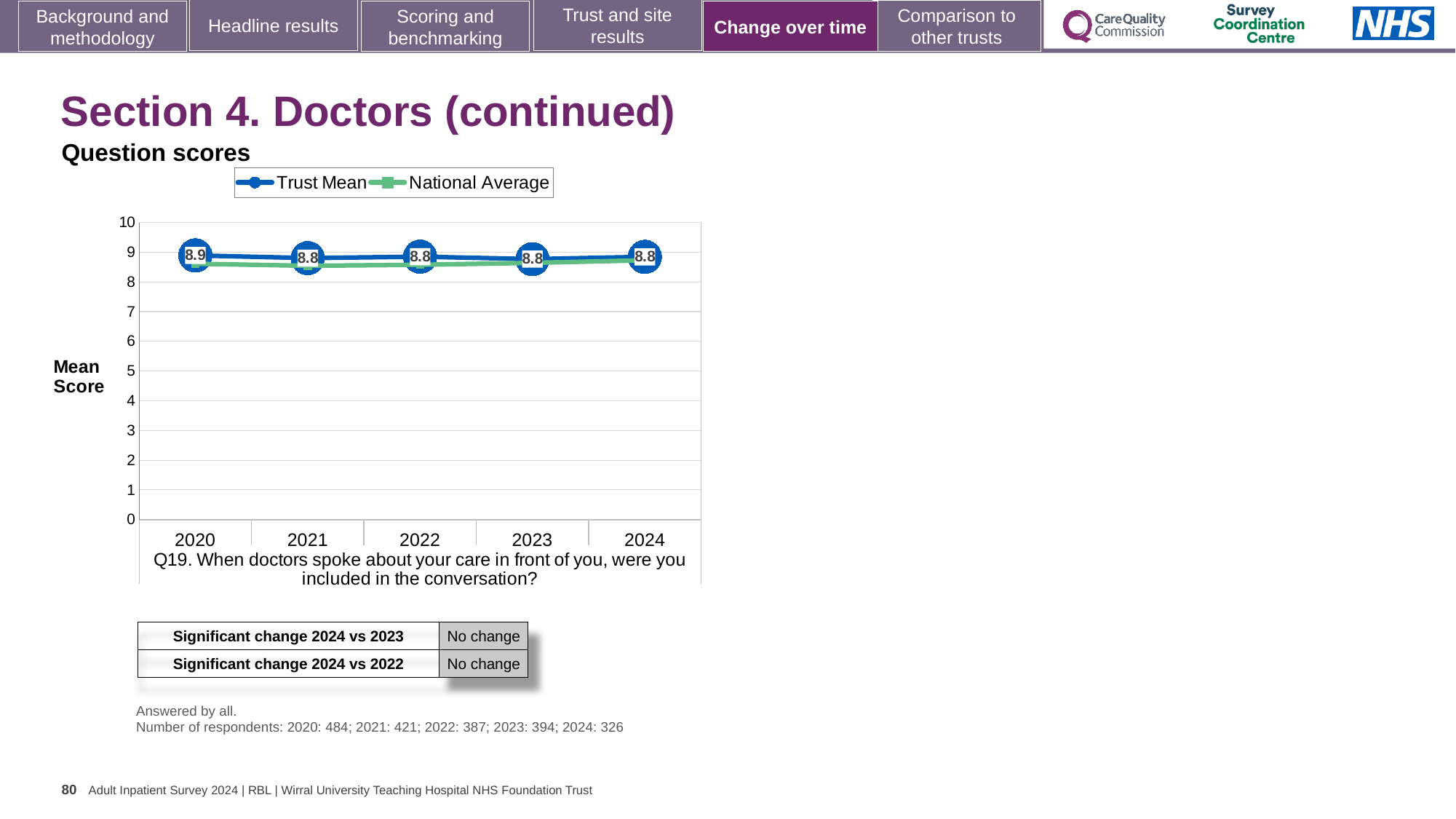
In which year was the Trust Mean score highest? 2020 What is the Trust Mean score for 2022? 8.8 What is the Trust Mean score for 2024? 8.8 Is the National Average value for 2021 greater or less than 8? greater Did the Trust Mean score rise or fall between 2020 and 2021? fall What kind of chart is shown? line chart What is the difference between the Trust Mean score in 2020 and in 2024? 0.1 What is the label on the y axis of the chart? Mean Score How many years are plotted on the x axis? 5 How many series does the legend list? 2 What is the Trust Mean score for 2020? 8.9 Is the Trust Mean score for 2020 larger or smaller than the Trust Mean score for 2023? larger